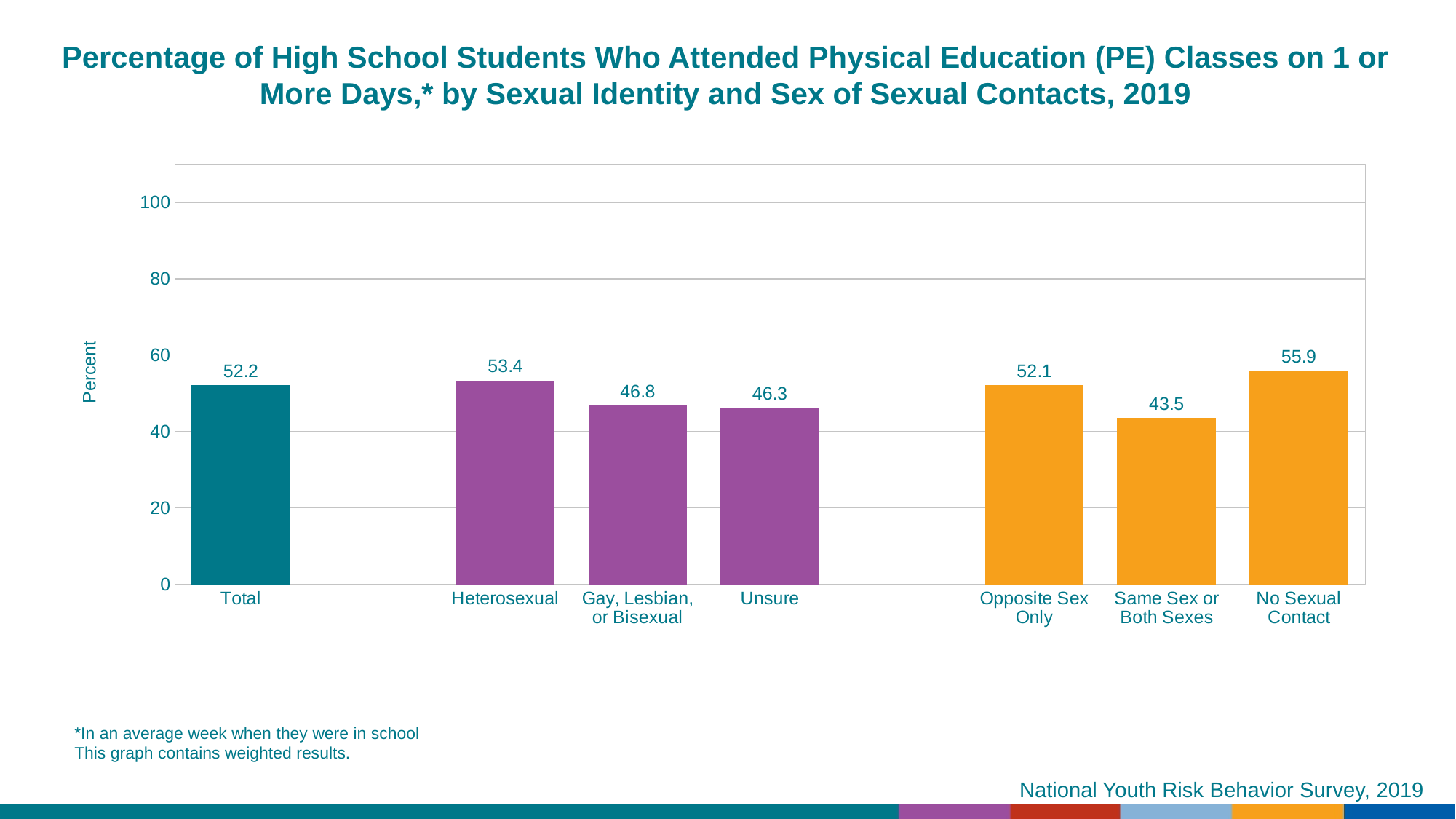
What is the value for Total? 52.2 What kind of chart is shown on the slide? bar chart What is the value for Heterosexual? 53.4 What is the value for Same Sex or Both Sexes? 43.5 Which category has the lowest value? Same Sex or Both Sexes What is the difference between the values for Heterosexual and Unsure? 7.1 What is the label of the y axis? Percent What is the difference between the values for No Sexual Contact and Same Sex or Both Sexes? 12.4 How many categories are shown on the chart? 7 Which is larger, the value for Gay, Lesbian, or Bisexual or the value for Unsure? Gay, Lesbian, or Bisexual Which category has the highest value? No Sexual Contact What is the value for No Sexual Contact? 55.9